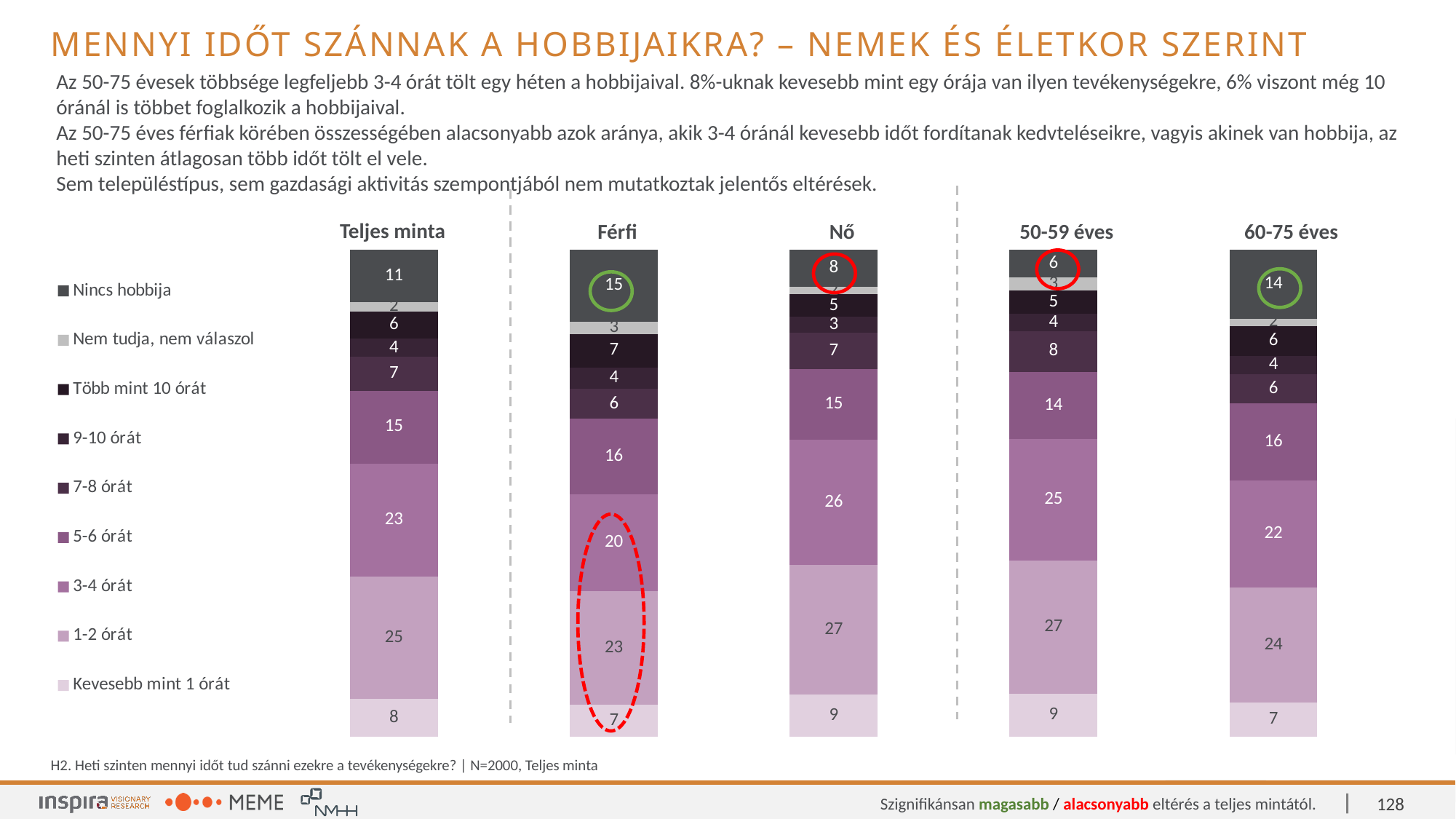
What is the value for 'Nincs hobbija' in the 'Férfi' bar? 15 How many series does the legend list? 9 What is the value for '1-2 órát' in the 'Nő' bar? 27 What kind of chart is shown on the slide? Stacked bar chart How many bars (groups) are plotted in the chart? 5 Which is larger: the '5-6 órát' value for '50-59 éves' or for '60-75 éves'? 60-75 éves What is the value for 'Kevesebb mint 1 órát' in the '60-75 éves' bar? 7 Which bar has the lowest value for 'Nincs hobbija'? 50-59 éves What is the value for '3-4 órát' in the 'Teljes minta' bar? 23 What is the difference between the '3-4 órát' values for 'Nő' and 'Férfi'? 6 Which legend entry is listed first (at the top) in the legend? Nincs hobbija Which bar has the highest value for 'Nincs hobbija'? Férfi